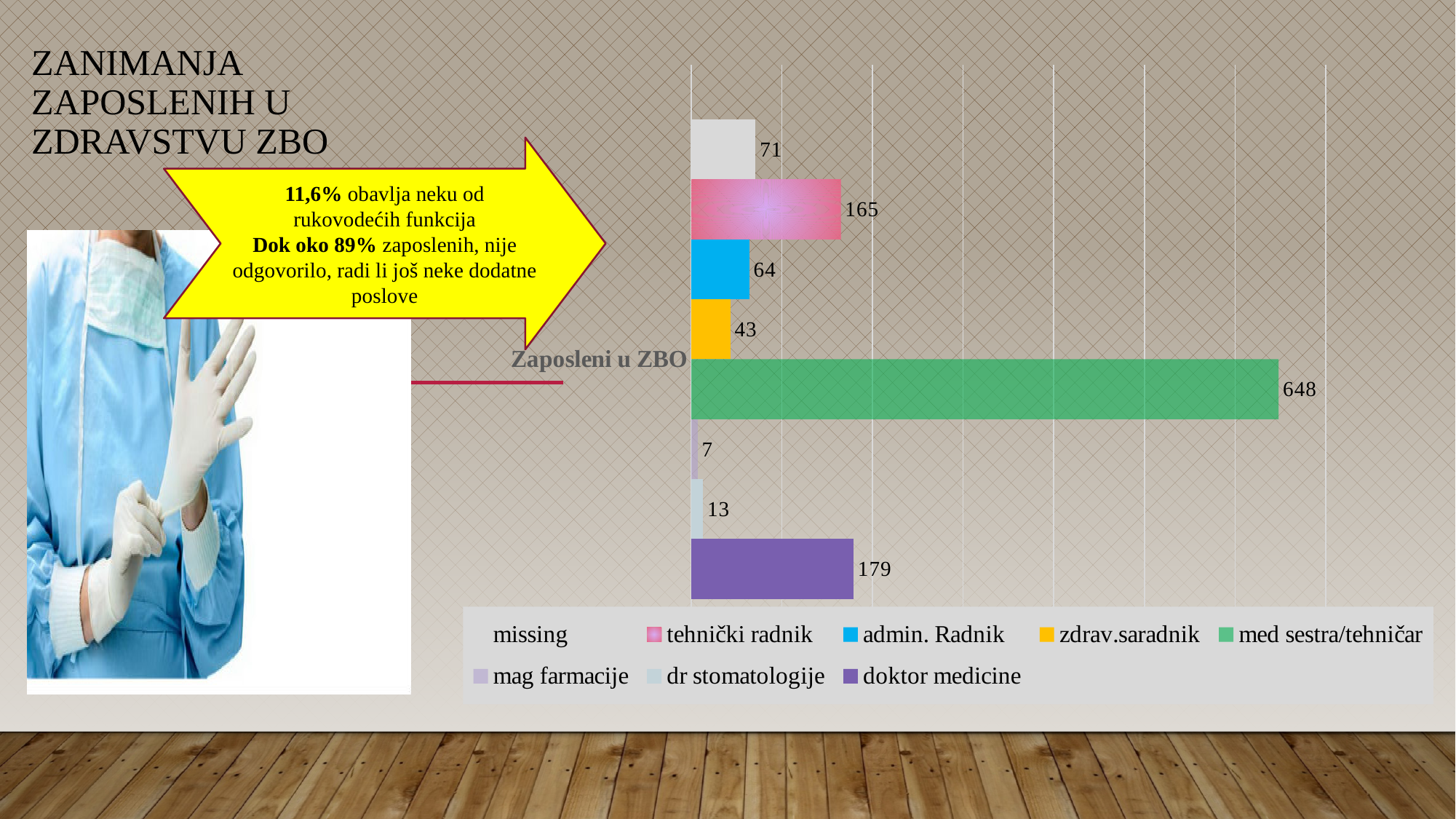
Which series has the lowest value? mag farmacije What is the value for doktor medicine? 179 What is the value for tehnički radnik? 165 Which is larger, the value for zdrav.saradnik or the value for dr stomatologije? zdrav.saradnik What is the value for med sestra/tehničar? 648 What is the value for mag farmacije? 7 What is the difference between the values for doktor medicine and tehnički radnik? 14 Which series has the highest value? med sestra/tehničar What kind of chart is shown on the slide? bar chart What is the category label shown on the vertical axis of the chart? Zaposleni u ZBO How many series does the legend list? 8 What is the difference between the values for missing and admin. Radnik? 7